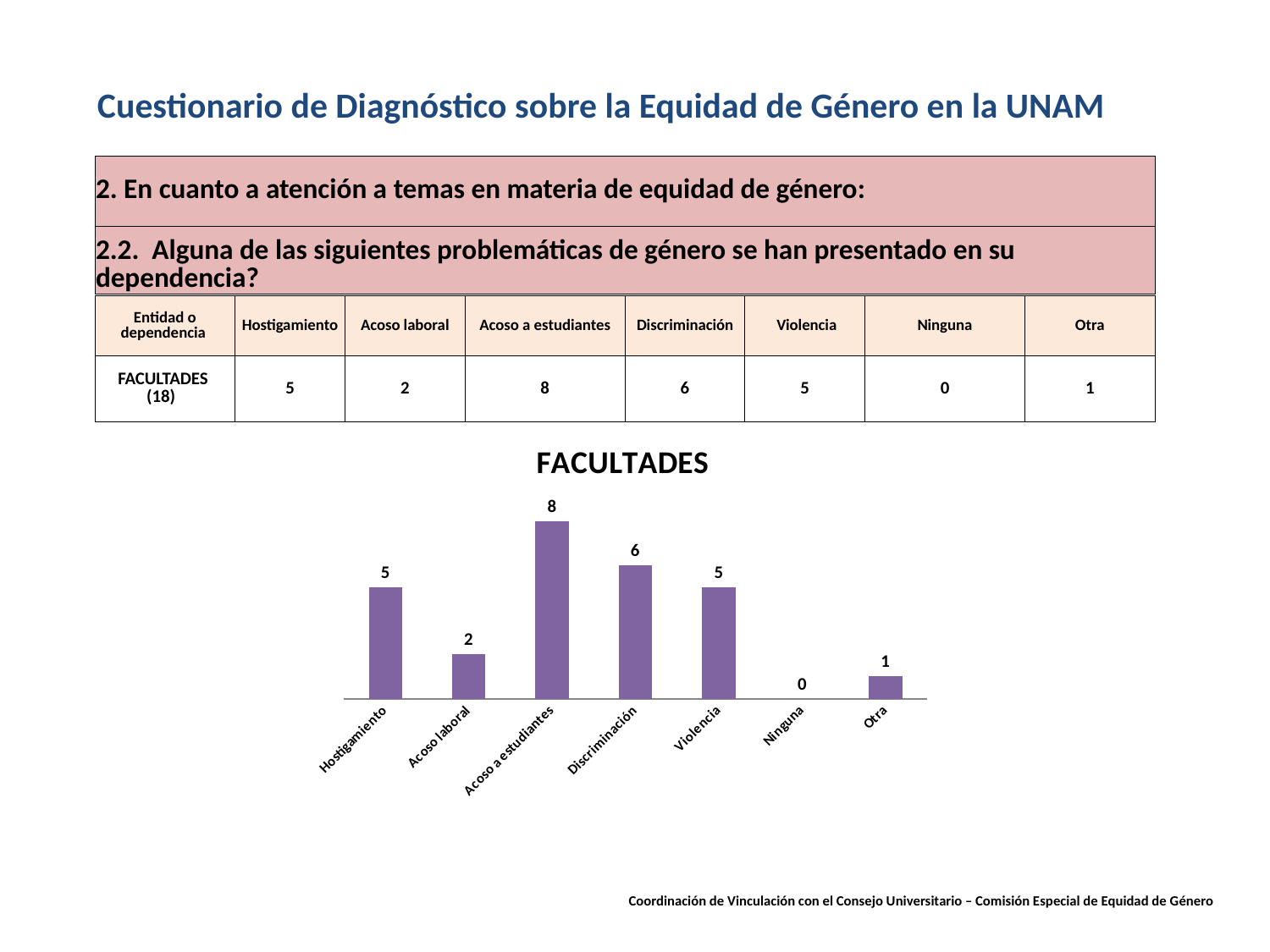
What kind of chart is the FACULTADES chart? Bar chart How many categories are shown in the FACULTADES chart? 7 What is the value for Discriminación in the FACULTADES chart? 6 Which is larger in the FACULTADES chart, Hostigamiento or Acoso laboral? Hostigamiento What is the value for Otra in the FACULTADES chart? 1 What is the difference between the values for Violencia and Otra in the FACULTADES chart? 4 What is the value for Acoso laboral in the FACULTADES chart? 2 Which category has the lowest value in the FACULTADES chart? Ninguna Which category has the highest value in the FACULTADES chart? Acoso a estudiantes What is the difference between the values for Acoso a estudiantes and Discriminación in the FACULTADES chart? 2 What is the title of the chart on the slide? FACULTADES What is the value for Acoso a estudiantes in the FACULTADES chart? 8